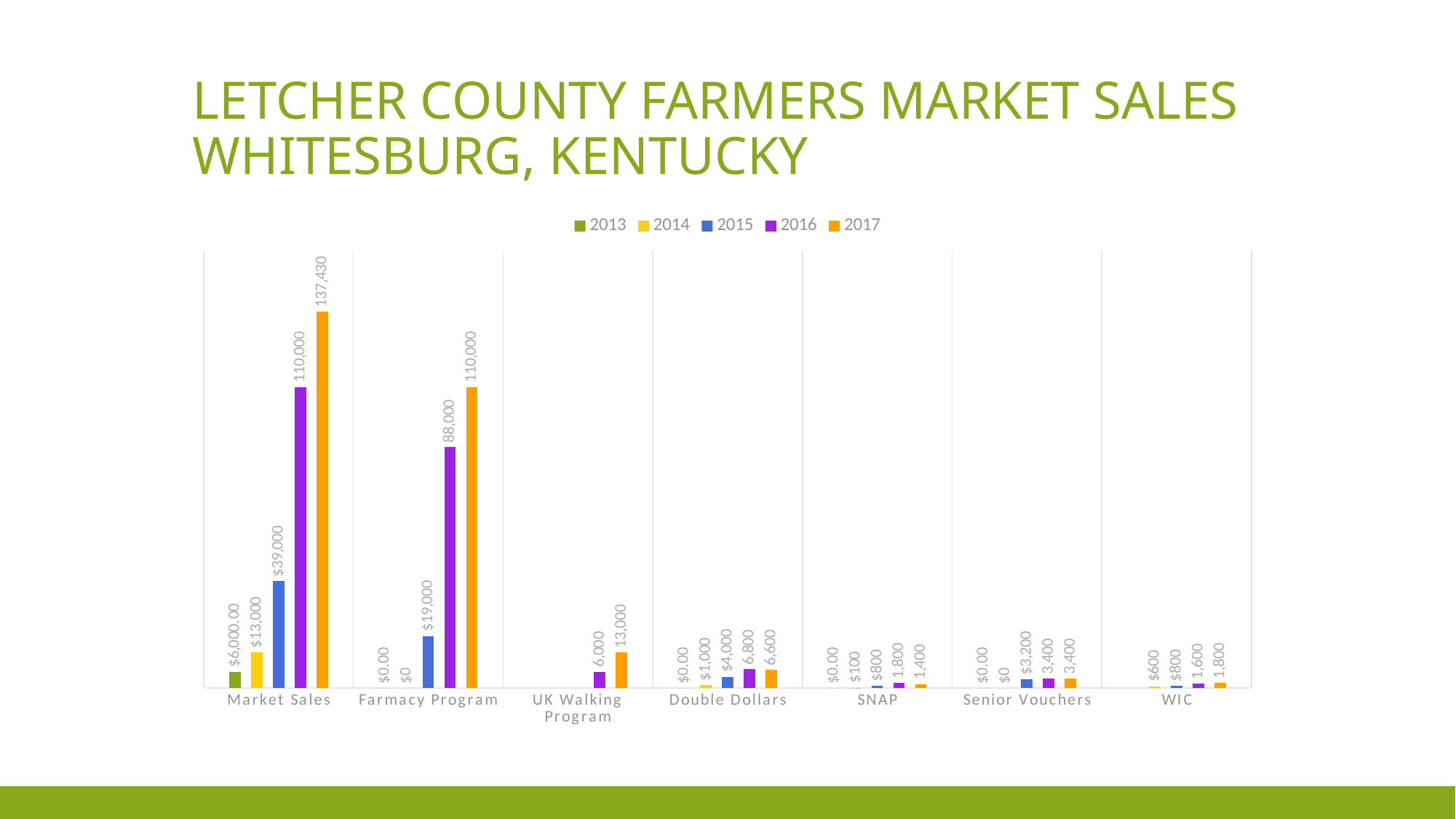
What is the 2017 value for Market Sales? 137,430 What kind of chart is shown on the slide? Bar chart Which year has the lowest value for WIC among the labelled years? 2014 What is the 2014 value for SNAP? $100 Do the Farmacy Program values rise or fall from 2015 to 2017? Rise Which is larger for Double Dollars, the 2016 value or the 2017 value? 2016 How many series does the legend list? 5 Which category has the highest 2017 value? Market Sales What is the 2015 value for the Farmacy Program? $19,000 What is the difference between the 2017 and 2016 values for Market Sales? 27,430 What is the 2016 value for the UK Walking Program? 6,000 How many categories are shown on the x axis? 7